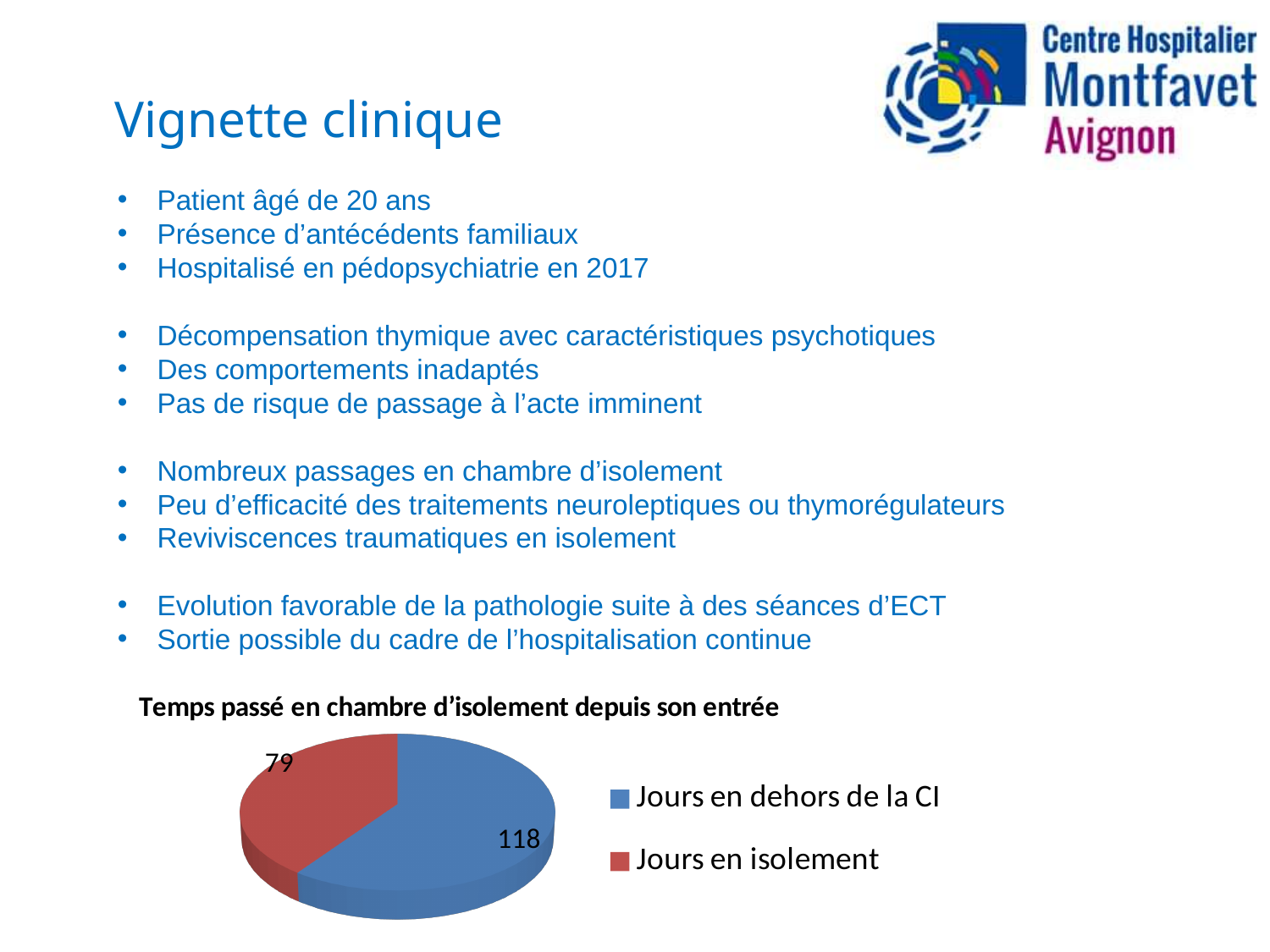
Which category has the largest slice in the pie chart? Jours en dehors de la CI What is the total of the two values shown in the pie chart? 197 What type of chart is shown on the slide? pie chart What is the title of the chart on the slide? Temps passé en chambre d'isolement depuis son entrée Which category has the smallest slice in the pie chart? Jours en isolement What is the value for 'Jours en isolement' in the pie chart? 79 Which colour represents 'Jours en isolement' in the pie chart? red How many slices does the pie chart have? 2 How many entries does the legend of the pie chart list? 2 Which is larger, 'Jours en isolement' or 'Jours en dehors de la CI'? Jours en dehors de la CI What is the value for 'Jours en dehors de la CI' in the pie chart? 118 What is the difference between 'Jours en dehors de la CI' and 'Jours en isolement'? 39